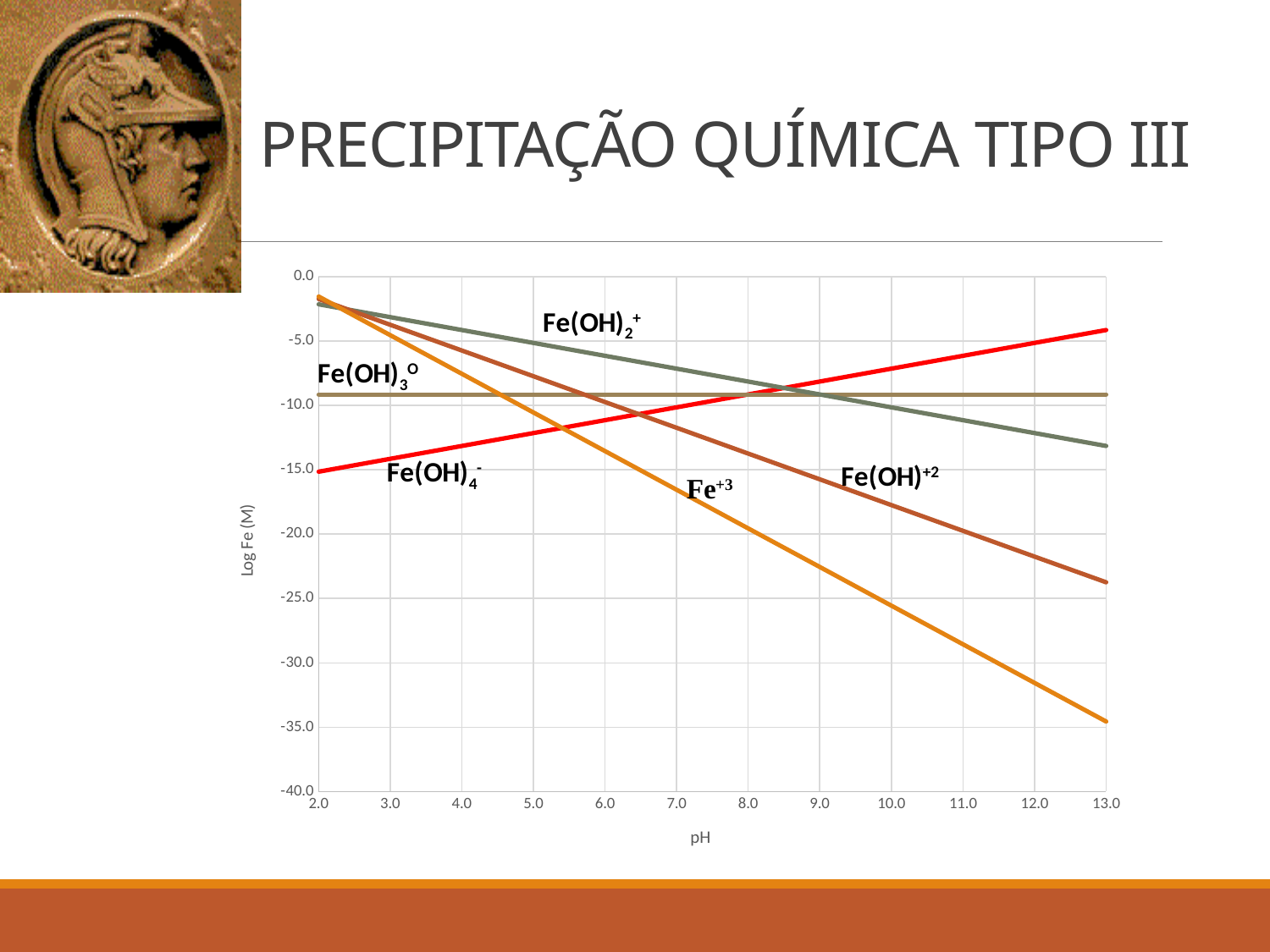
How many labelled lines (species) are plotted on the chart? 5 What kind of chart is shown on the slide? line chart Which line stays flat (constant) across the whole pH range? Fe(OH)3° Which species has the lowest Log Fe value at pH 13.0? Fe+3 Which species has the highest Log Fe value at pH 13.0? Fe(OH)4- What is the label of the y axis? Log Fe (M) At pH 2.0, which has the higher Log Fe value: Fe(OH)2+ or Fe(OH)4-? Fe(OH)2+ Is the Log Fe value of Fe(OH)+2 at pH 13.0 greater or less than -20.0? less Does the Fe(OH)4- line rise or fall as pH increases? rises What is the label of the x axis? pH Does the Fe+3 line rise or fall as pH increases? falls Is the Log Fe value of Fe+3 at pH 13.0 greater or less than -30.0? less